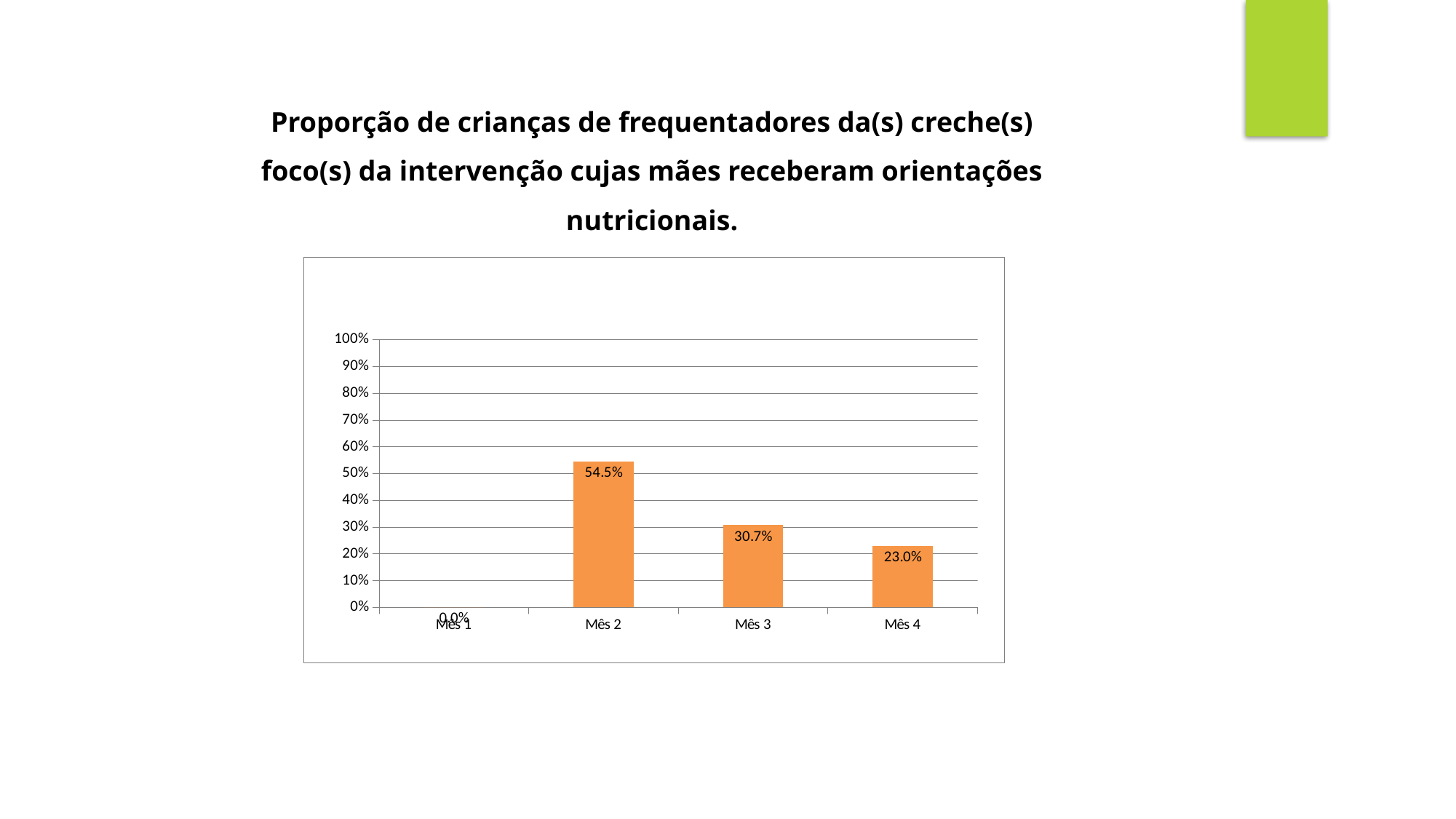
What kind of chart is shown on the slide? Bar chart Which month has the lowest value? Mês 1 What is the value for Mês 4? 23.0% Which is larger, the value for Mês 3 or the value for Mês 4? Mês 3 What is the value for Mês 1? 0.0% What is the value for Mês 3? 30.7% Which month has the highest value? Mês 2 What is the value for Mês 2? 54.5% Is the value for Mês 2 greater or less than 50%? greater What is the difference between the values for Mês 3 and Mês 4? 7.7% What is the difference between the values for Mês 2 and Mês 3? 23.8% How many months are shown on the x axis? 4